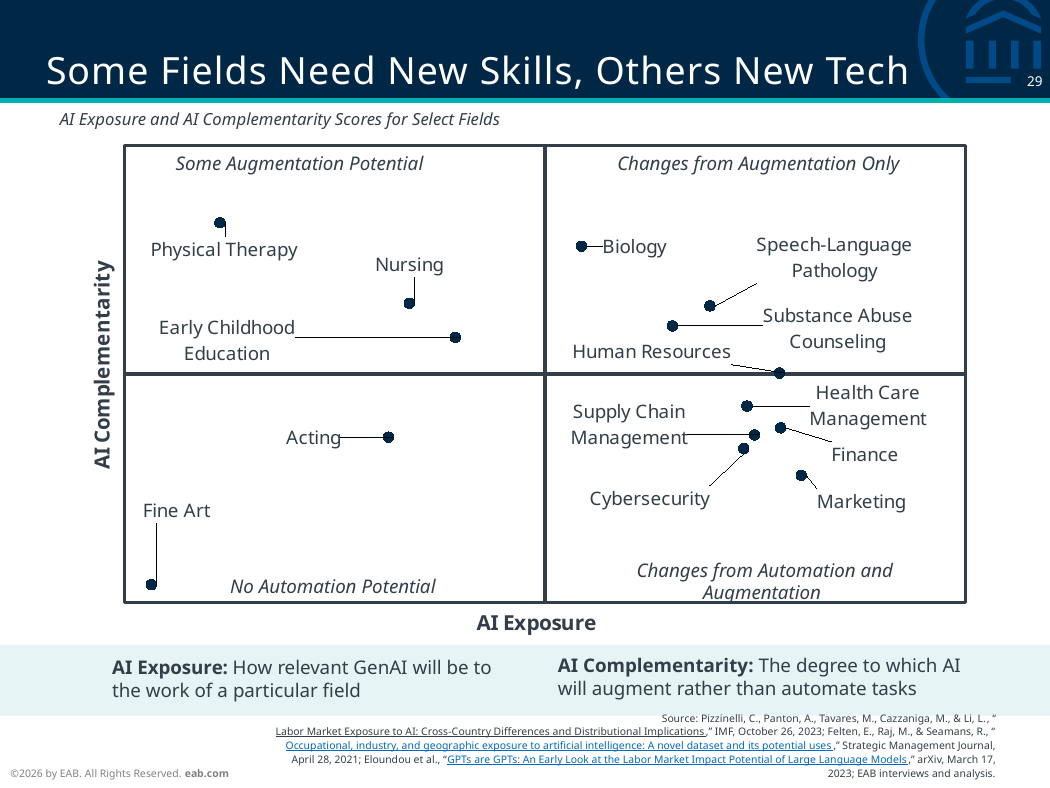
In which quadrant of the chart does Cybersecurity appear? Changes from Automation and Augmentation What is the title of the chart? AI Exposure and AI Complementarity Scores for Select Fields In which quadrant of the chart does Acting appear? No Automation Potential Which field has the highest AI Complementarity on the chart? Physical Therapy What is the label of the vertical axis? AI Complementarity How many fields are plotted as points on the chart? 14 Which has higher AI Exposure, Nursing or Biology? Biology Which field has the lowest AI Exposure on the chart? Fine Art Which field has the lowest AI Complementarity on the chart? Fine Art Which has higher AI Complementarity, Acting or Early Childhood Education? Early Childhood Education Which field has the highest AI Exposure on the chart? Marketing What kind of chart is shown on the slide? Scatter plot